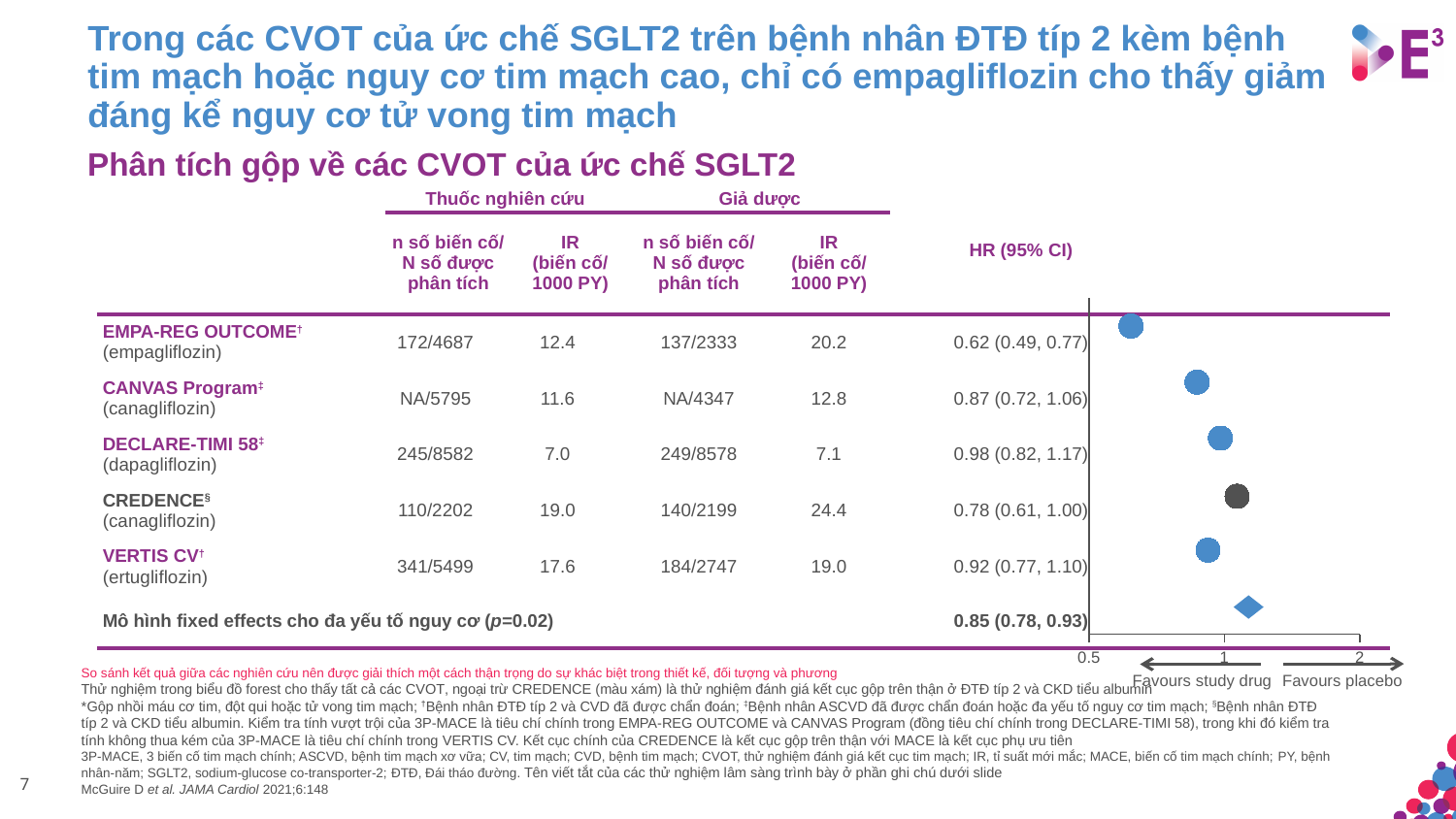
What is the HR (95% CI) for the fixed effects model (pooled estimate)? 0.85 (0.78, 0.93) Which has the larger hazard ratio, CREDENCE or VERTIS CV? VERTIS CV Which trial is plotted with a grey marker in the forest plot? CREDENCE What kind of chart is shown on the slide? Forest plot How many individual trials are plotted in the forest plot (excluding the pooled estimate)? 5 Which trial has the highest hazard ratio? DECLARE-TIMI 58 What is the HR (95% CI) for CREDENCE? 0.78 (0.61, 1.00) What is the p-value shown for the fixed effects model? p=0.02 What is the difference between the hazard ratio of DECLARE-TIMI 58 and that of EMPA-REG OUTCOME? 0.36 Is the hazard ratio for CANVAS Program greater or less than 1? less What is the HR (95% CI) for EMPA-REG OUTCOME? 0.62 (0.49, 0.77) Which trial has the lowest hazard ratio? EMPA-REG OUTCOME